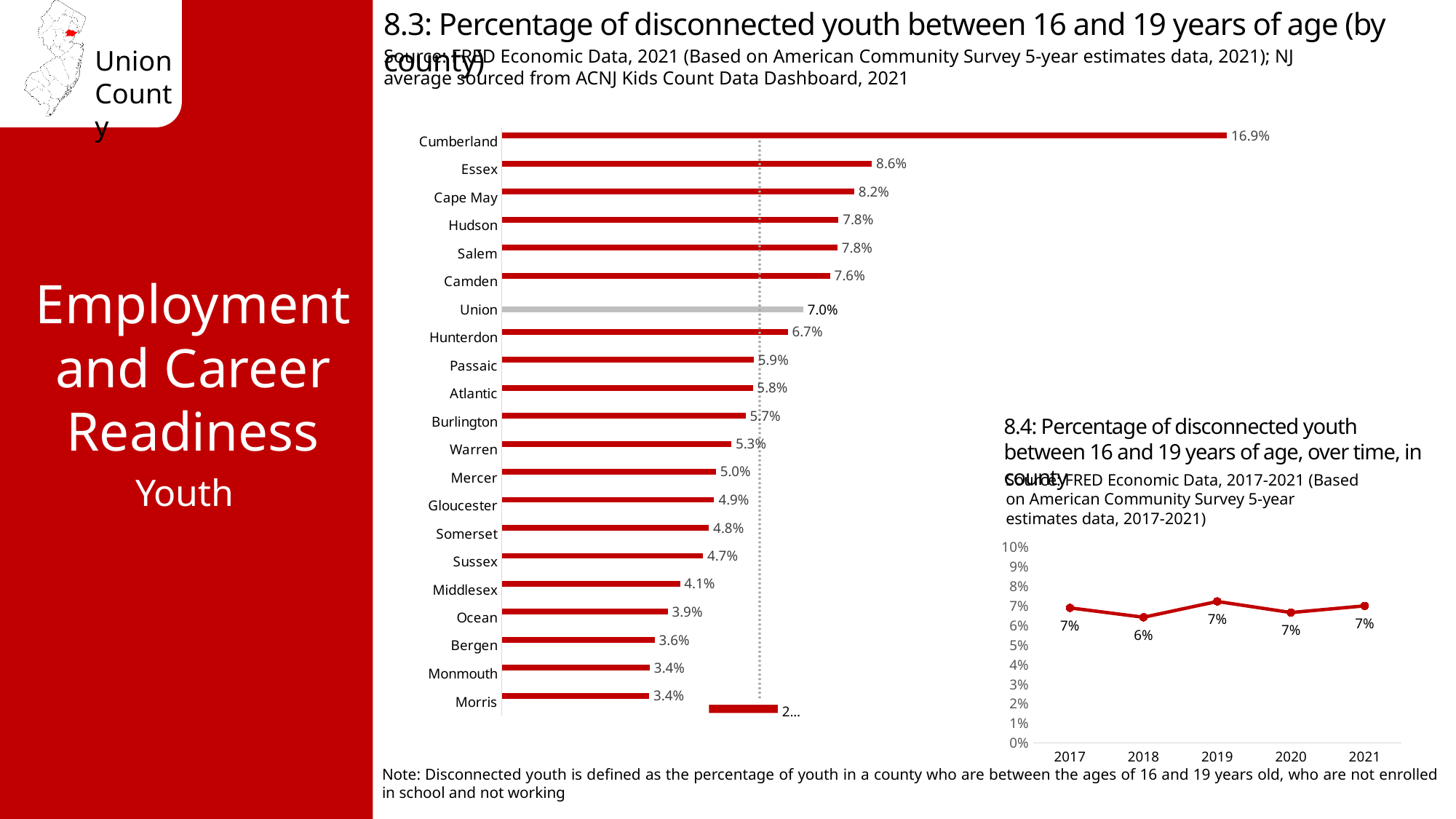
In chart 8.4 (percentage of disconnected youth over time), what is the value for 2018? 6% What kind of chart is chart 8.4 (percentage of disconnected youth over time)? Line chart In chart 8.3 (percentage of disconnected youth by county), what is the value for Middlesex? 4.1% In chart 8.4 (percentage of disconnected youth over time), is the value for 2019 greater or less than 5%? greater In chart 8.3 (percentage of disconnected youth by county), which is larger, the value for Hunterdon or the value for Passaic? Hunterdon What kind of chart is chart 8.3 (percentage of disconnected youth by county)? Bar chart In chart 8.3 (percentage of disconnected youth by county), what is the value for Union? 7.0% In chart 8.3 (percentage of disconnected youth by county), how many counties are plotted? 21 In chart 8.3 (percentage of disconnected youth by county), which county has the highest value? Cumberland In chart 8.4 (percentage of disconnected youth over time), how many years are plotted? 5 In chart 8.3 (percentage of disconnected youth by county), what is the value for Cape May? 8.2% In chart 8.3 (percentage of disconnected youth by county), what is the difference between Cumberland and Essex? 8.3%